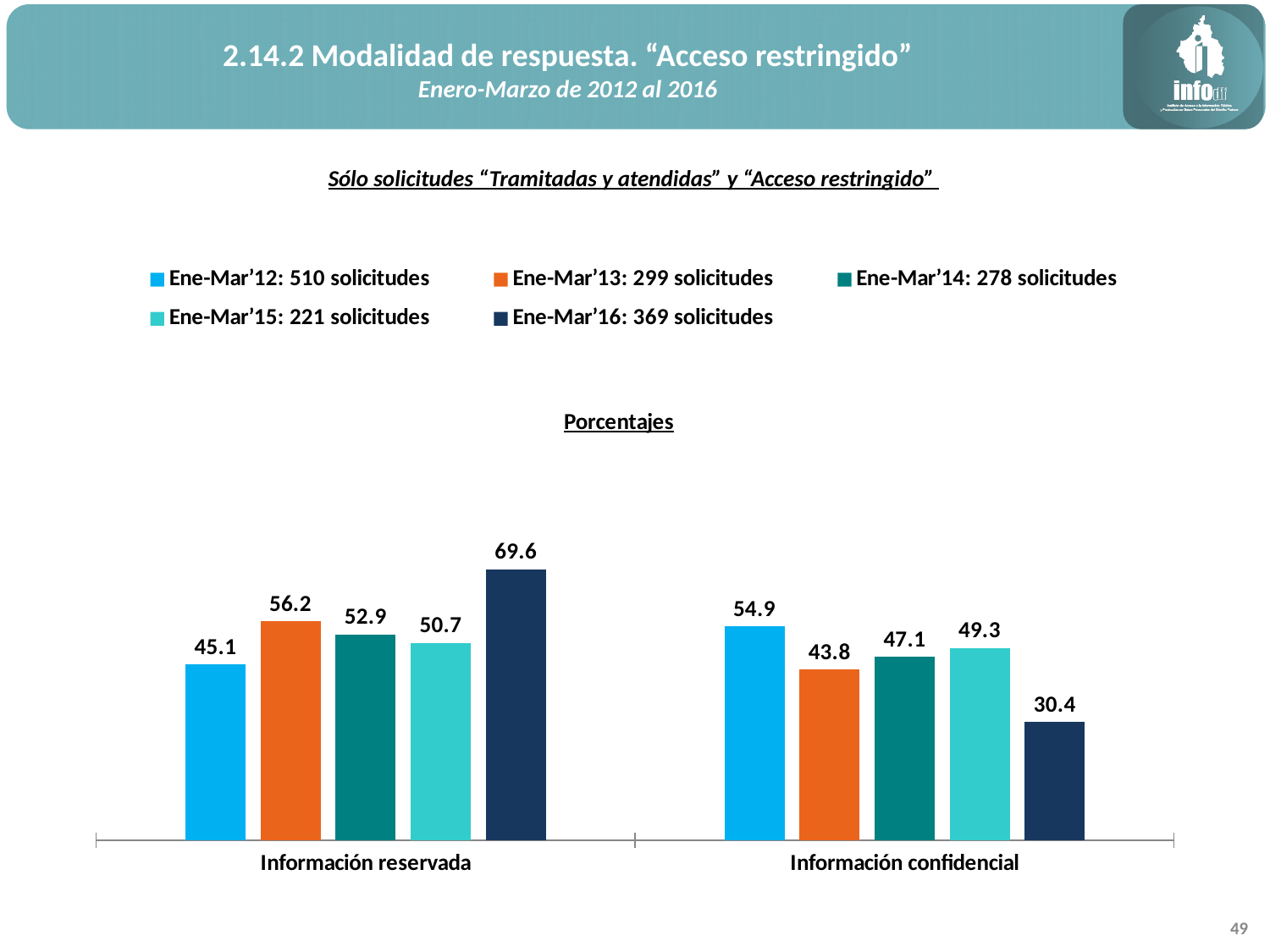
How many series does the legend list? 5 What is the value for Ene-Mar'13 in the Información confidencial category? 43.8 What is the difference between the Ene-Mar'13 and Ene-Mar'12 values for Información reservada? 11.1 What kind of chart is shown on the slide? Bar chart According to the legend, how many solicitudes were there in Ene-Mar'15? 221 solicitudes Which series has the highest value in the Información confidencial category? Ene-Mar'12: 510 solicitudes What is the difference between the Ene-Mar'16 values for Información reservada and Información confidencial? 39.2 What is the value for Ene-Mar'16 in the Información reservada category? 69.6 Which series has the lowest value in the Información confidencial category? Ene-Mar'16: 369 solicitudes Which is larger: the Ene-Mar'14 value for Información reservada or for Información confidencial? Información reservada What is the value for Ene-Mar'12 in the Información reservada category? 45.1 How many categories are shown on the x axis? 2